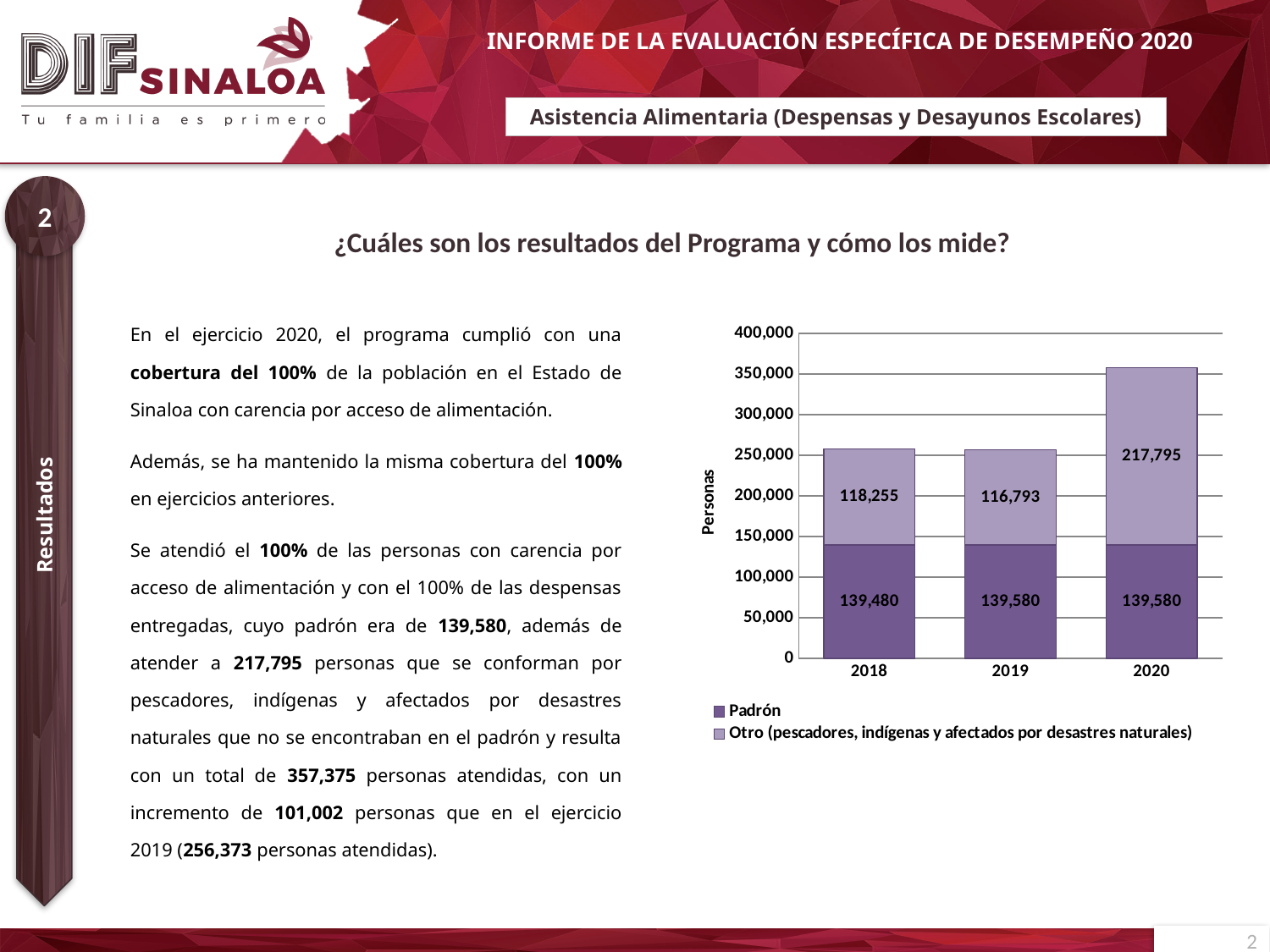
What is the value of the 'Otro (pescadores, indígenas y afectados por desastres naturales)' series for 2020? 217,795 What is the total of the stacked bar for 2020? 357,375 Which year has the lowest value for the 'Otro' series? 2019 What is the difference between the 'Otro' values for 2020 and 2019? 101,002 What is the Padrón value for 2018? 139,480 Which year has the highest value for the 'Otro' series? 2020 What is the value of the 'Otro' series for 2019? 116,793 What kind of chart is shown on the slide? stacked bar chart What is the total of the stacked bar for 2019? 256,373 Is the 'Otro' value for 2020 larger or smaller than the Padrón value for 2020? larger How many years are shown on the x axis of the chart? 3 How many series does the chart legend list? 2